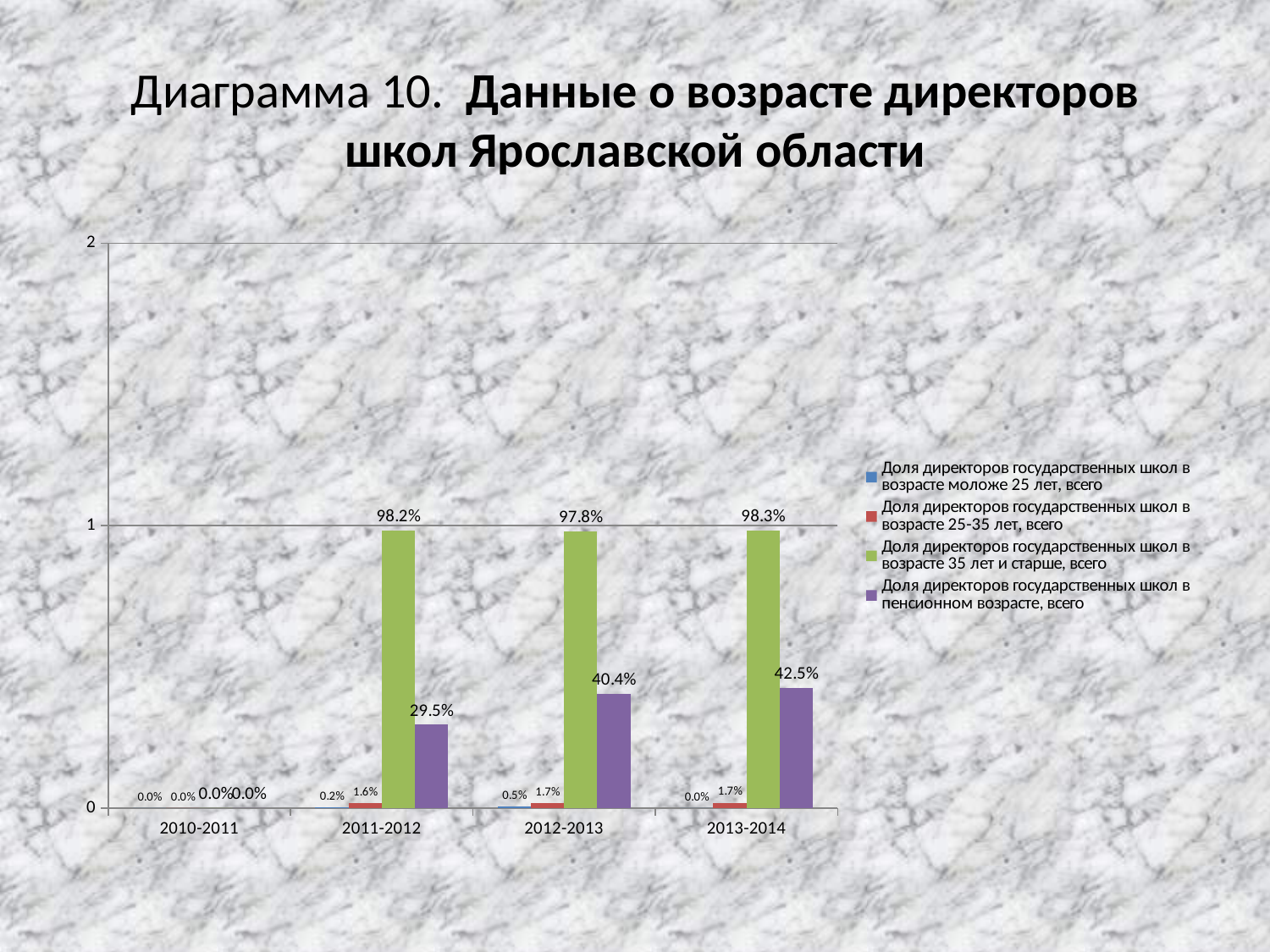
In which school year is the share of directors of retirement age the highest? 2013-2014 Does the share of directors of retirement age rise or fall from 2011-2012 to 2013-2014? rise How many series does the legend list? 4 What is the value for directors aged 35 and older (Доля директоров государственных школ в возрасте 35 лет и старше, всего) in 2011-2012? 98.2% What type of chart is shown on the slide? bar chart How many categories (school years) are shown on the x axis? 4 What is the value for directors younger than 25 (Доля директоров государственных школ в возрасте моложе 25 лет, всего) in 2012-2013? 0.5% What is the value for directors aged 25-35 (Доля директоров государственных школ в возрасте 25-35 лет, всего) in 2012-2013? 1.7% What is the value for directors of retirement age (Доля директоров государственных школ в пенсионном возрасте, всего) in 2013-2014? 42.5% What is the difference between the share of directors of retirement age in 2013-2014 and in 2011-2012? 13.0% Among the years 2011-2012, 2012-2013 and 2013-2014, in which year is the share of directors aged 35 and older the lowest? 2012-2013 Which is larger: the share of directors of retirement age in 2012-2013 or in 2011-2012? 2012-2013